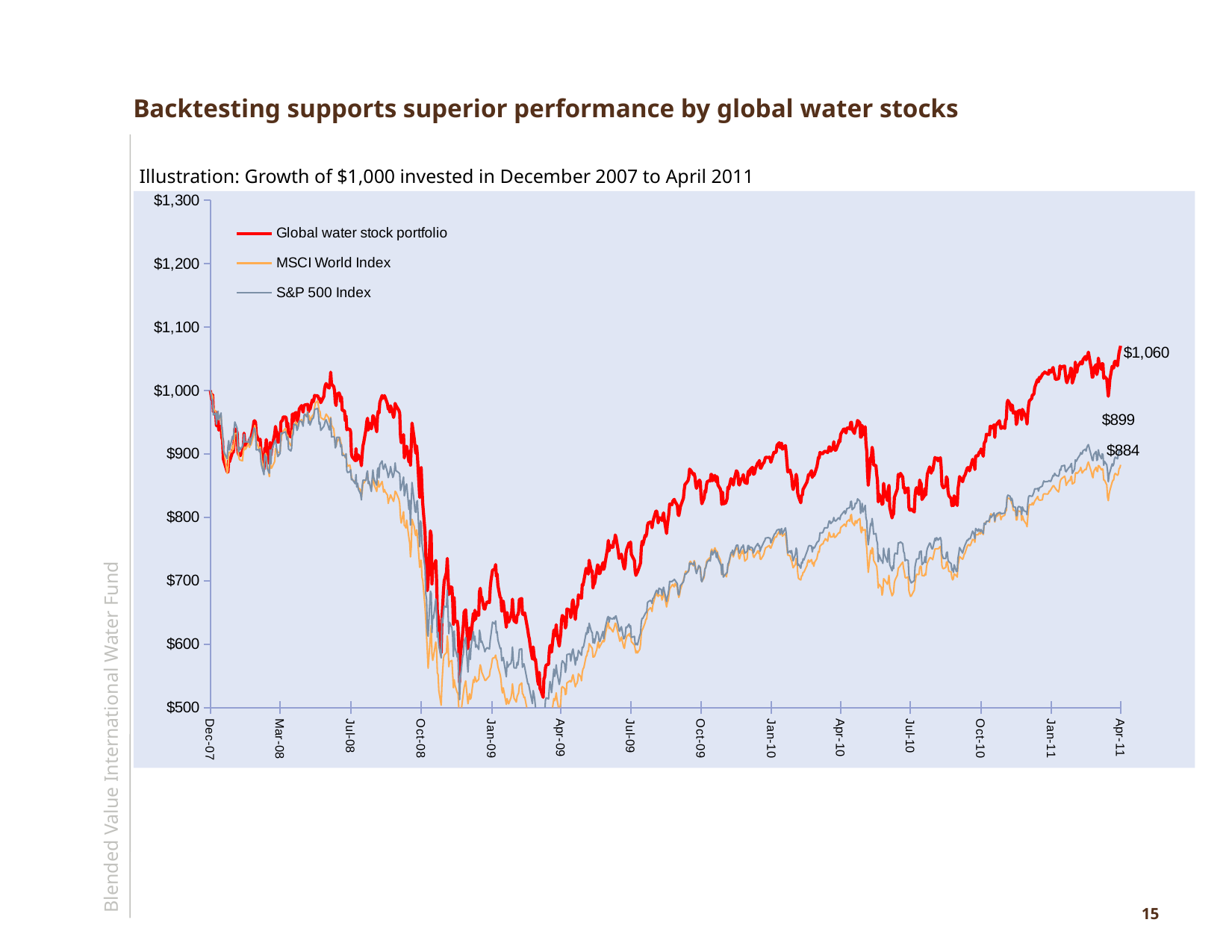
What kind of chart is shown on the slide? line chart What is the final value of the S&P 500 Index at Apr-11? $899 Which series ends with the lowest value at Apr-11? MSCI World Index Is the value of the Global water stock portfolio at Jan-11 greater or less than $1,000? greater How many series does the legend list? 3 What is the difference between the final values of the Global water stock portfolio and the MSCI World Index? $176 What is the final value of the MSCI World Index at Apr-11? $884 Which series ends with the highest value at Apr-11? Global water stock portfolio What colour is the line for the Global water stock portfolio? red What is the final value of the Global water stock portfolio at Apr-11? $1,060 What is the difference between the final values of the Global water stock portfolio and the S&P 500 Index? $161